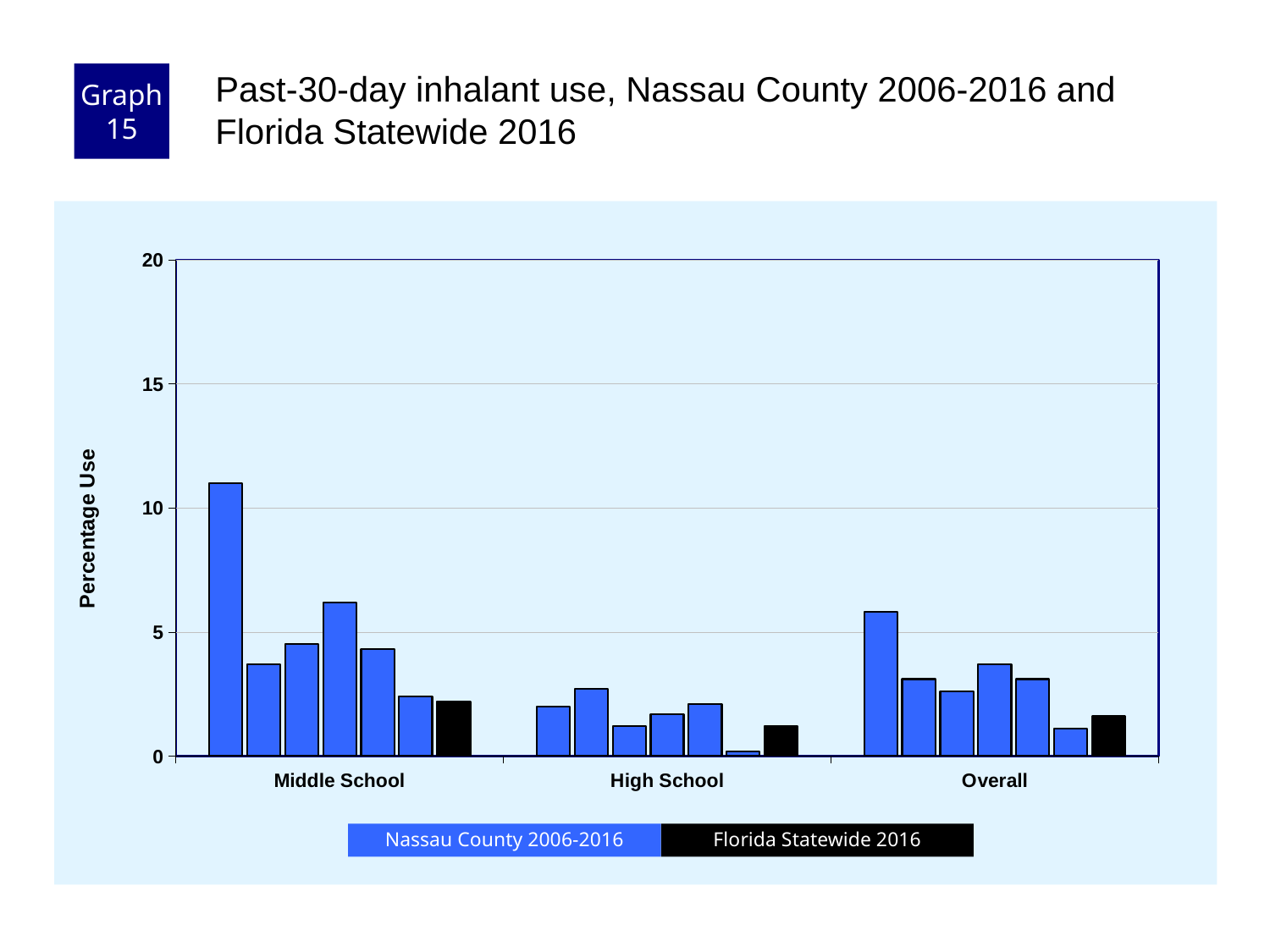
Is the Florida Statewide 2016 value larger for Middle School or for High School? Middle School Which category contains the tallest bar on the chart? Middle School Which series is shown in black? Florida Statewide 2016 How many categories are shown along the x axis? 3 Is the tallest High School bar greater or less than 5? less Is the value of the tallest Overall bar greater or less than 5? greater What is the label of the y axis? Percentage Use How many series does the legend list? 2 Is the Florida Statewide 2016 value for Middle School greater or less than 5? less What kind of chart is shown on the slide? bar chart Which category contains the shortest bar on the chart? High School